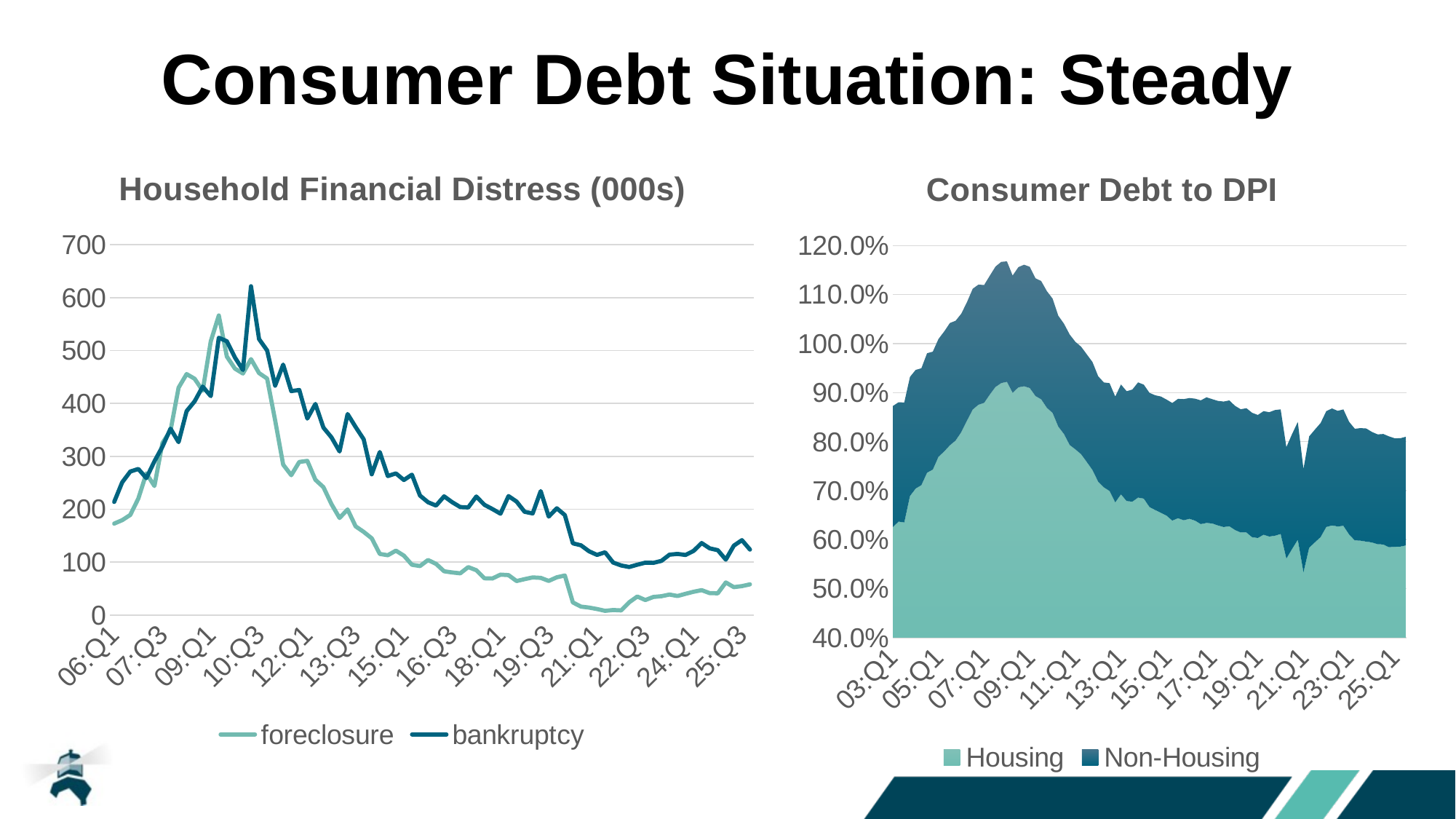
What kind of chart is the 'Consumer Debt to DPI' chart? stacked area chart In the 'Household Financial Distress (000s)' chart, which series reaches the higher peak, foreclosure or bankruptcy? bankruptcy In the 'Consumer Debt to DPI' chart, is the total (Housing plus Non-Housing) at 03:Q1 greater or less than 80.0%? greater In the 'Household Financial Distress (000s)' chart, does the foreclosure series rise or fall between 10:Q3 and 21:Q1? fall In the 'Household Financial Distress (000s)' chart, is the foreclosure value at 06:Q1 greater or less than 200? less In the 'Household Financial Distress (000s)' chart, is the bankruptcy value at 25:Q3 greater or less than 100? greater How many series does the legend of the 'Household Financial Distress (000s)' chart list? 2 What kind of chart is the 'Household Financial Distress (000s)' chart? line chart How many series does the legend of the 'Consumer Debt to DPI' chart list? 2 In the 'Consumer Debt to DPI' chart, which series is shown in the lighter green colour? Housing